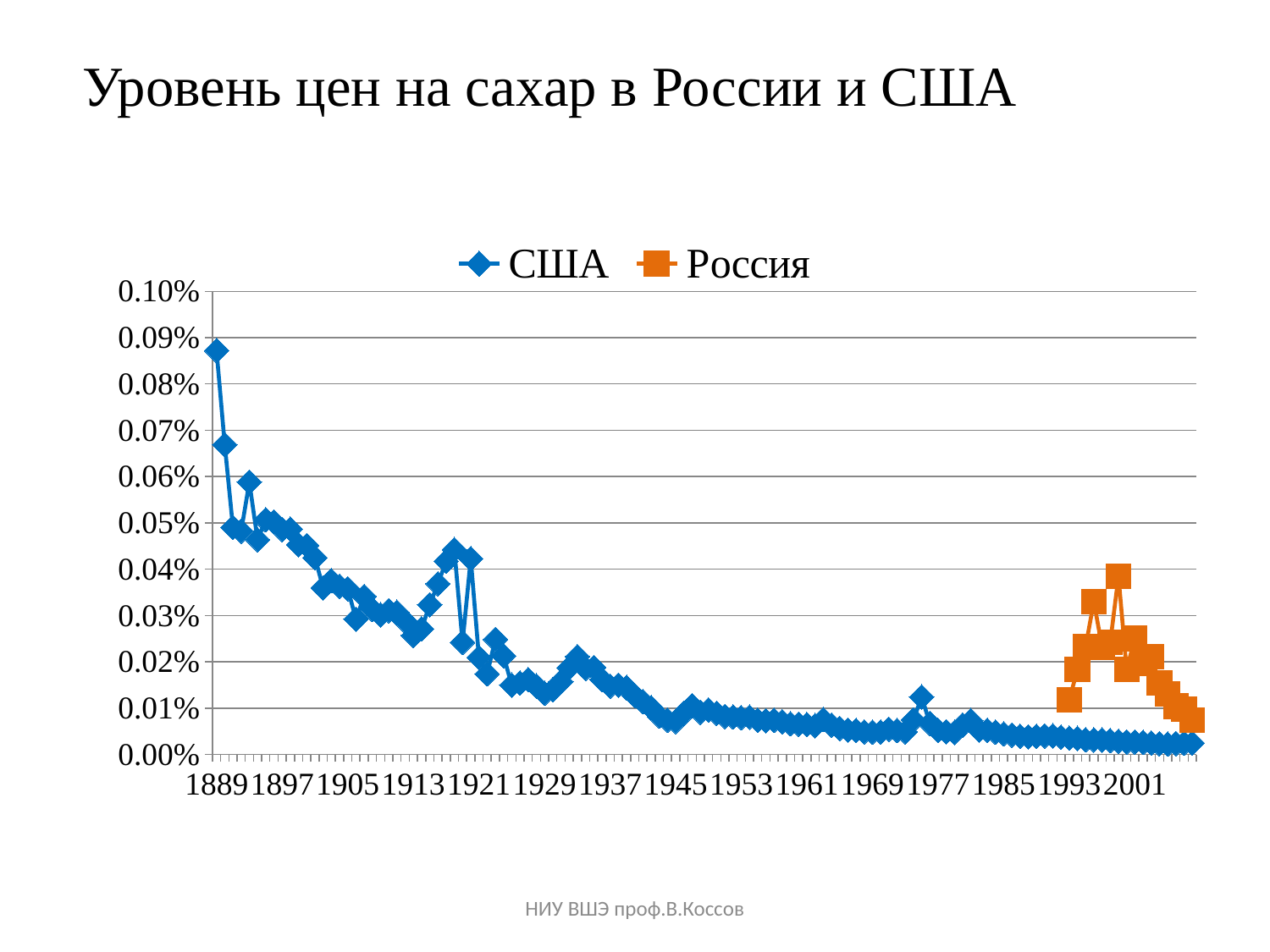
In which year does the США series reach its highest value? 1889 Which series starts at the earliest year on the x axis, США or Россия? США What kind of chart is shown on the slide? line chart What is the title of the chart on the slide? Уровень цен на сахар в России и США Overall, do the values for США rise or fall from 1889 to the end of the x axis? fall Is the highest value of the Россия series greater or less than 0.03%? greater Which is larger: the highest value of США or the highest value of Россия? США Around 2001, which series has the larger value, США or Россия? Россия Is the value for США in 1969 greater or less than 0.01%? less How many series does the legend list? 2 Is the value for США in 1889 greater or less than 0.08%? greater What are the two series named in the legend? США and Россия